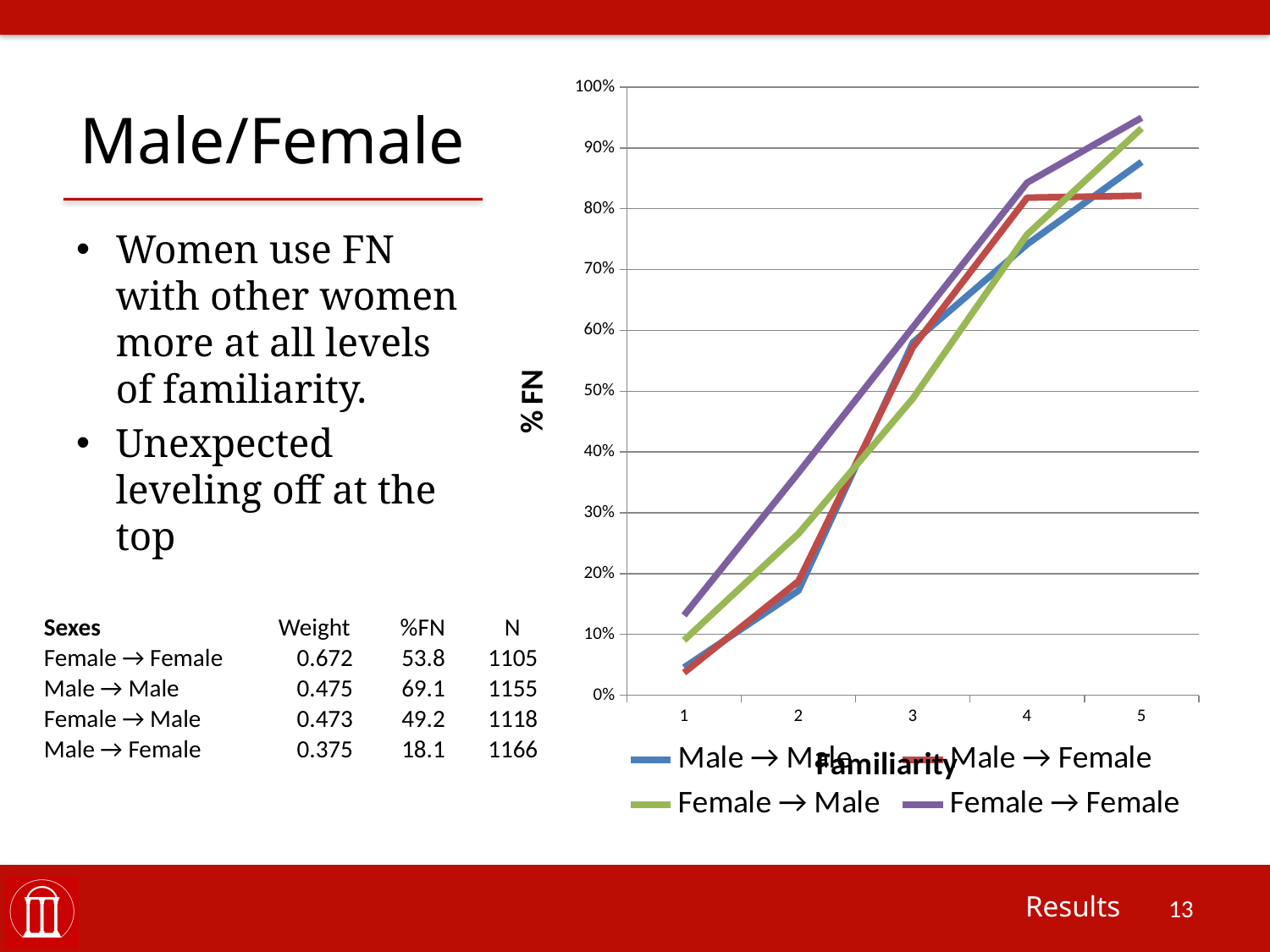
Which series has the lowest value at familiarity 5? Male → Female Does the Female → Female line rise or fall as familiarity increases from 1 to 5? rises How many series does the chart's legend list? 4 Is the value for Male → Female at familiarity 5 greater or less than 90%? less What kind of chart is shown on the slide? line chart At familiarity 3, which is larger: Female → Male or Female → Female? Female → Female Which series has the highest value at familiarity 1? Female → Female How many familiarity levels are plotted along the x axis of the chart? 5 Is the value for Male → Male at familiarity 2 greater or less than 20%? less Is the value for Female → Female at familiarity 1 greater or less than 10%? greater